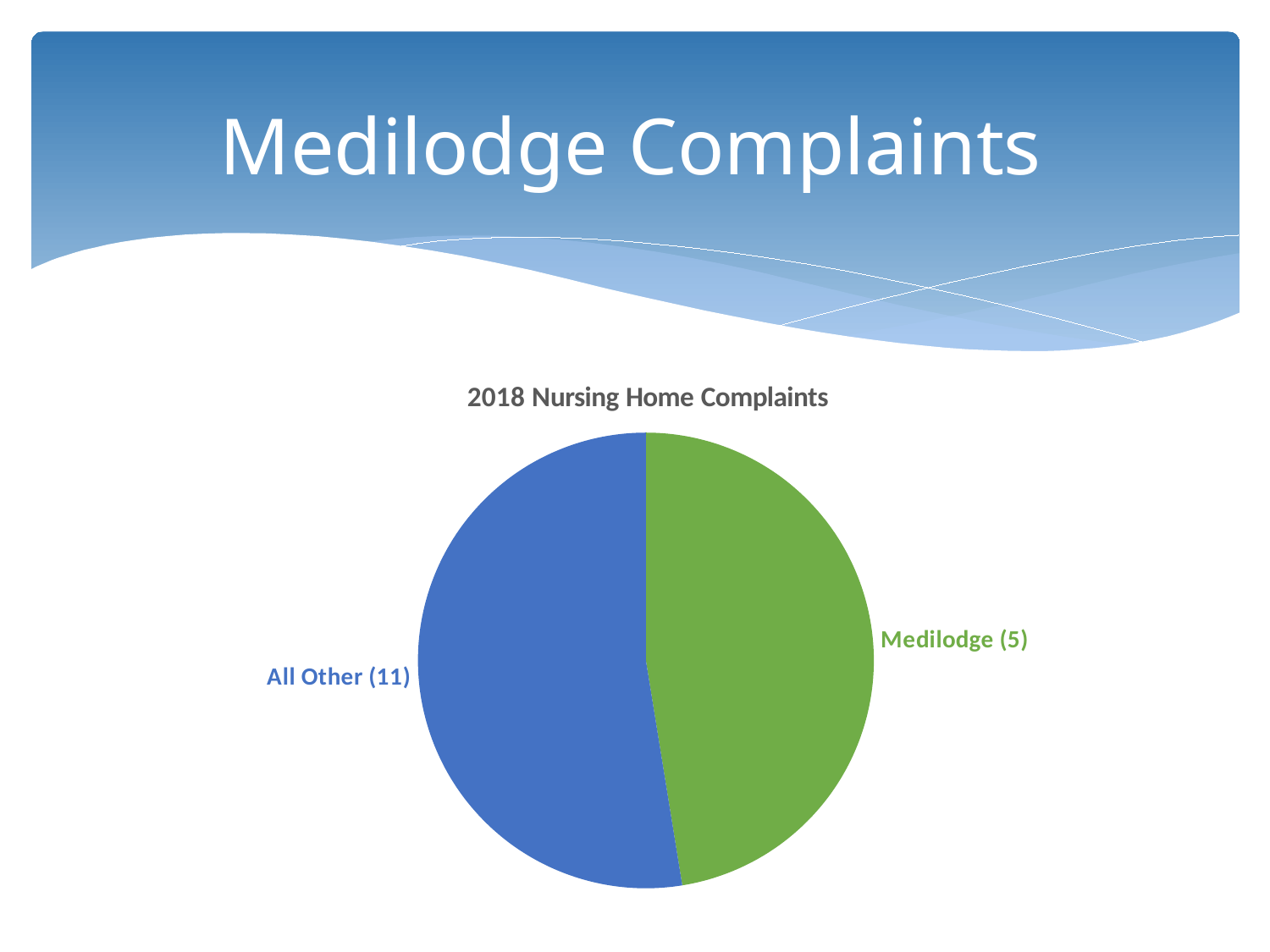
Which slice of the pie chart is the largest? All Other How many complaints are attributed to Medilodge in the pie chart? 5 What is the title of the chart? 2018 Nursing Home Complaints Which slice of the pie chart is the smallest? Medilodge What colour is the Medilodge slice in the pie chart? Green How many complaints are attributed to All Other in the pie chart? 11 How many slices does the pie chart have? 2 Which has more complaints, Medilodge or All Other? All Other What is the total number of complaints shown in the pie chart? 16 What is the difference between the All Other and Medilodge complaint counts? 6 What type of chart is shown on the slide? Pie chart